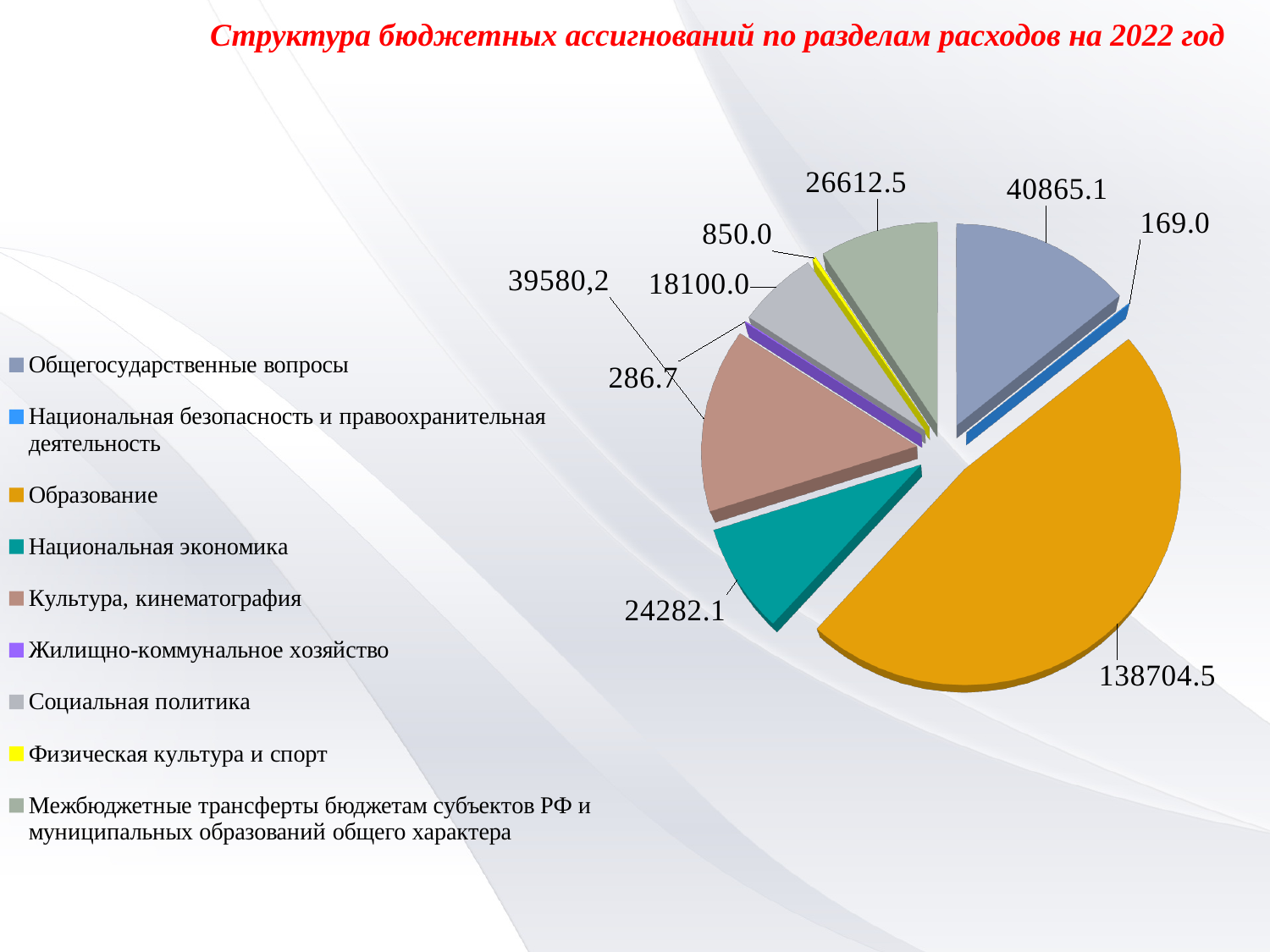
Which category has the smallest value? Национальная безопасность и правоохранительная деятельность What is the value for Общегосударственные вопросы? 40865.1 What is the value for Социальная политика? 18100.0 What is the title of the chart? Структура бюджетных ассигнований по разделам расходов на 2022 год What is the value for Образование? 138704.5 What is the value for Национальная экономика? 24282.1 Which is larger: Национальная экономика or Межбюджетные трансферты бюджетам субъектов РФ и муниципальных образований общего характера? Межбюджетные трансферты бюджетам субъектов РФ и муниципальных образований общего характера What is the difference between the values for Межбюджетные трансферты (26612.5) and Национальная экономика (24282.1)? 2330.4 What is the value for Физическая культура и спорт? 850.0 Which category has the largest slice of the pie? Образование What type of chart is shown on the slide? Pie chart How many categories does the pie chart have? 9